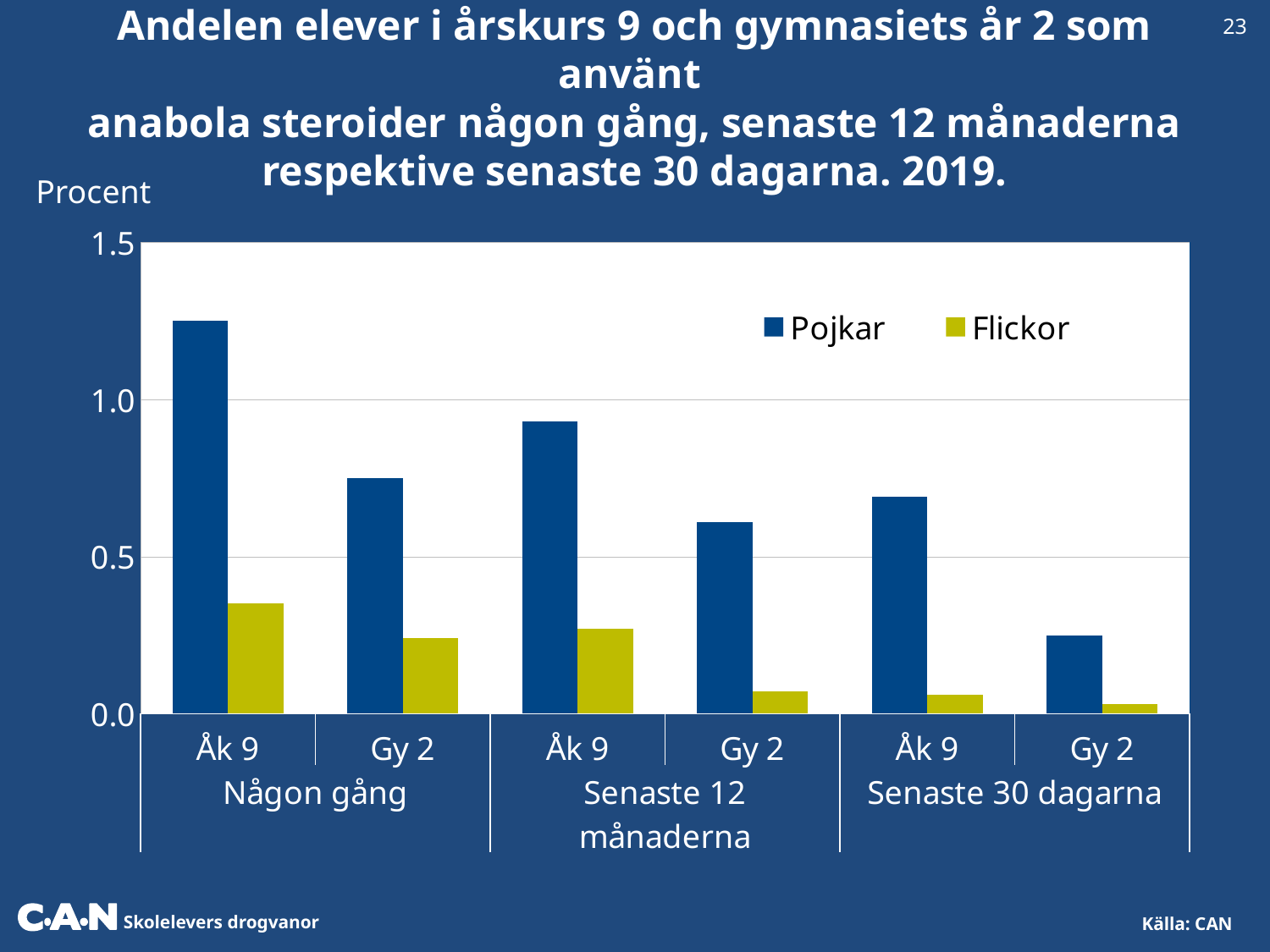
What label is shown on the vertical axis? Procent In Åk 9 under Senaste 30 dagarna, which is larger, Pojkar or Flickor? Pojkar How many bar groups (categories) are shown along the x axis? 6 Is the value for Flickor in Åk 9 under Någon gång greater or less than 0.5? less Is the value for Pojkar in Åk 9 under Någon gång greater or less than 1.0? greater What are the two series named in the legend? Pojkar and Flickor For which category is the Pojkar value highest? Åk 9, Någon gång How many series does the legend list? 2 Is the value for Pojkar in Åk 9 under Senaste 12 månaderna greater or less than 1.0? less What kind of chart is shown on the slide? bar chart For which category is the Pojkar value lowest? Gy 2, Senaste 30 dagarna